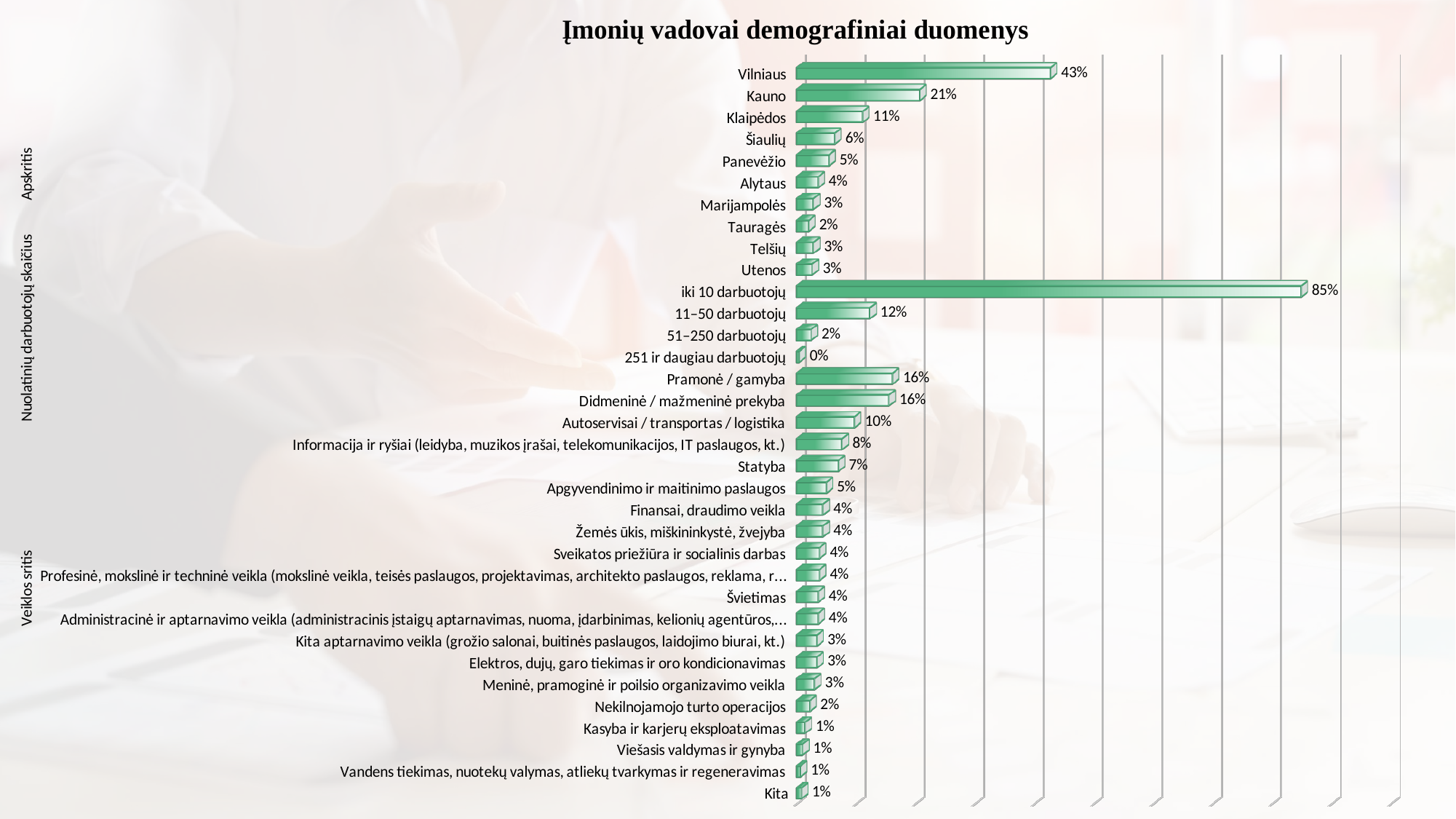
Which is larger, the value for Klaipėdos or the value for Šiaulių? Klaipėdos Which category has the lowest value? 251 ir daugiau darbuotojų What is the difference between the values for iki 10 darbuotojų and 11–50 darbuotojų? 73% What is the value for Kauno? 21% What is the value for iki 10 darbuotojų? 85% Which category has the highest value? iki 10 darbuotojų What is the title of the chart? Įmonių vadovai demografiniai duomenys What is the value for Statyba? 7% What is the difference between the values for Vilniaus and Kauno? 22% How many categories are plotted in the chart? 34 What is the value for Vilniaus? 43% What kind of chart is shown on the slide? Bar chart